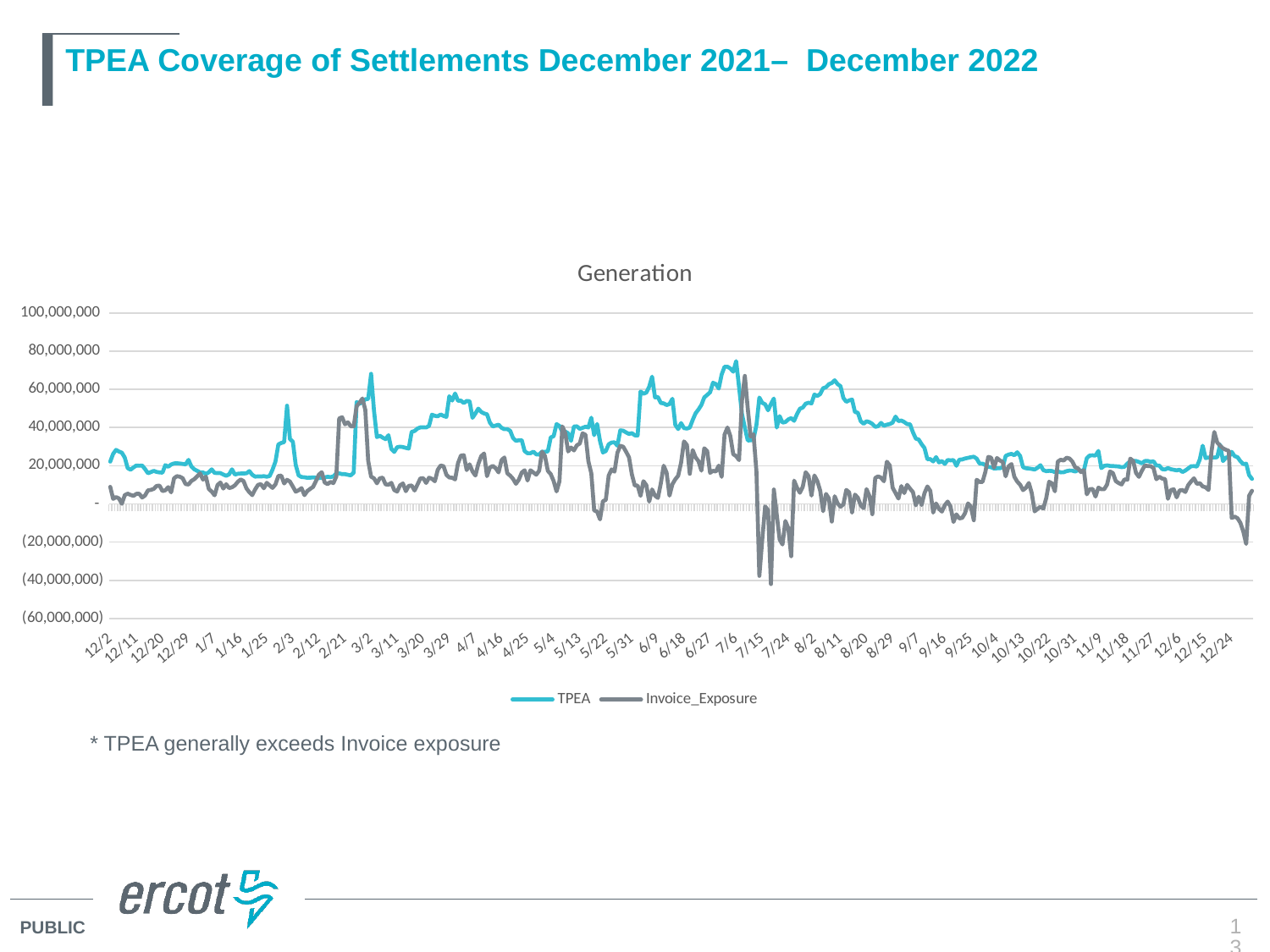
How many series does the legend list? 2 Does the TPEA series rise or fall between 8/11 and 9/16? fall What is the highest value shown on the vertical axis? 100,000,000 Is the value of TPEA around 3/2 greater or less than 60,000,000? greater What are the two series named in the legend? TPEA and Invoice_Exposure Is the peak value of TPEA around 7/6 greater or less than 60,000,000? greater Which series is higher at the start of the chart on 12/2, TPEA or Invoice_Exposure? TPEA What kind of chart is shown on the slide? line chart Which series reaches the lowest value on the chart? Invoice_Exposure What is the title of the chart? Generation Is the value of TPEA around 2/3 greater or less than 40,000,000? greater